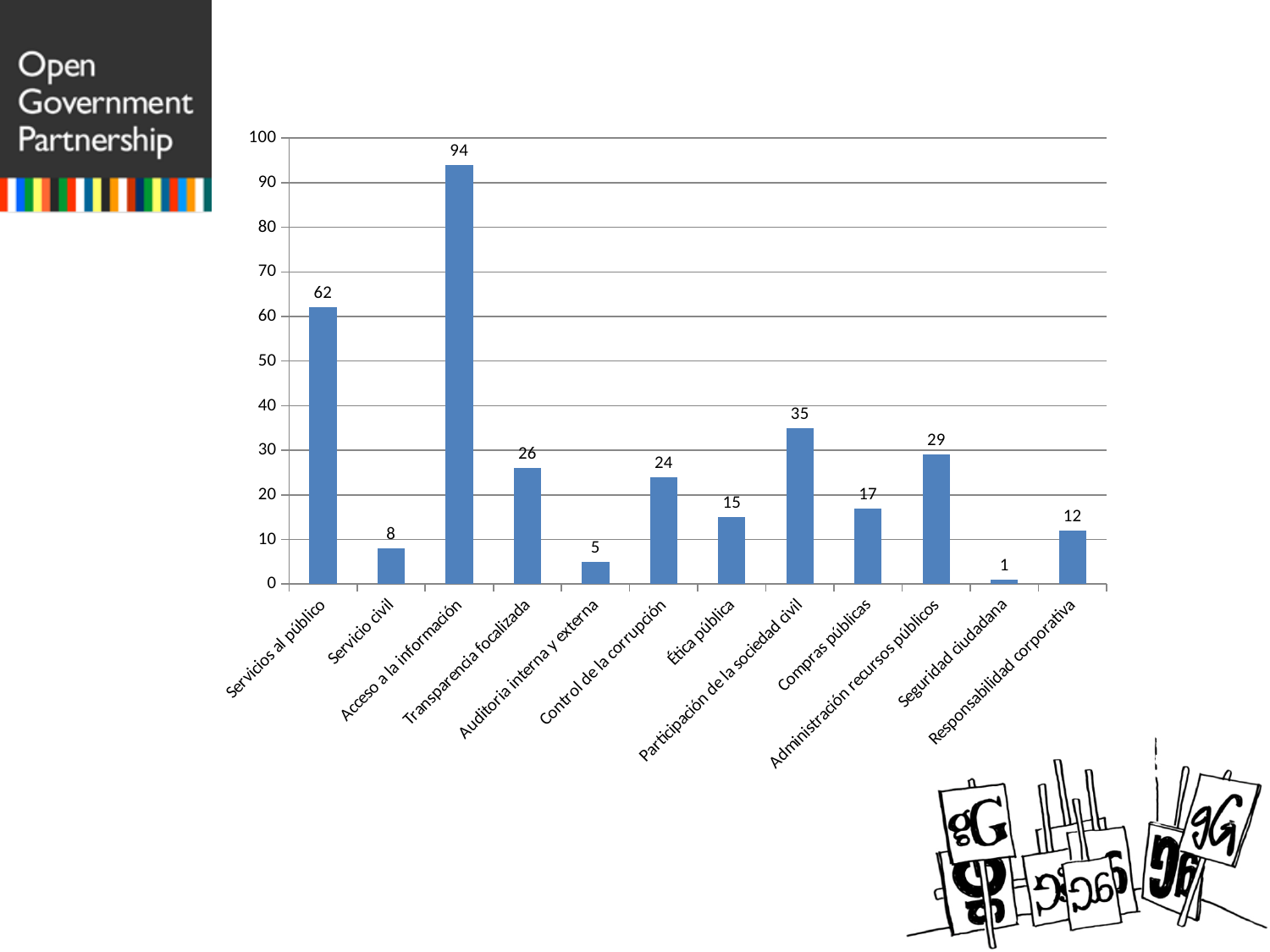
What is the value for Responsabilidad corporativa? 12 Which is larger, the value for Transparencia focalizada or the value for Control de la corrupción? Transparencia focalizada What is the difference between the values for Acceso a la información and Servicios al público? 32 What is the value for Participación de la sociedad civil? 35 Is the value for Administración recursos públicos greater or less than 20? greater Which category has the lowest value? Seguridad ciudadana What is the value for Acceso a la información? 94 Which category has the highest value? Acceso a la información What kind of chart is shown on the slide? bar chart What is the value for Seguridad ciudadana? 1 How many categories are shown on the x axis? 12 What is the difference between the values for Compras públicas and Ética pública? 2